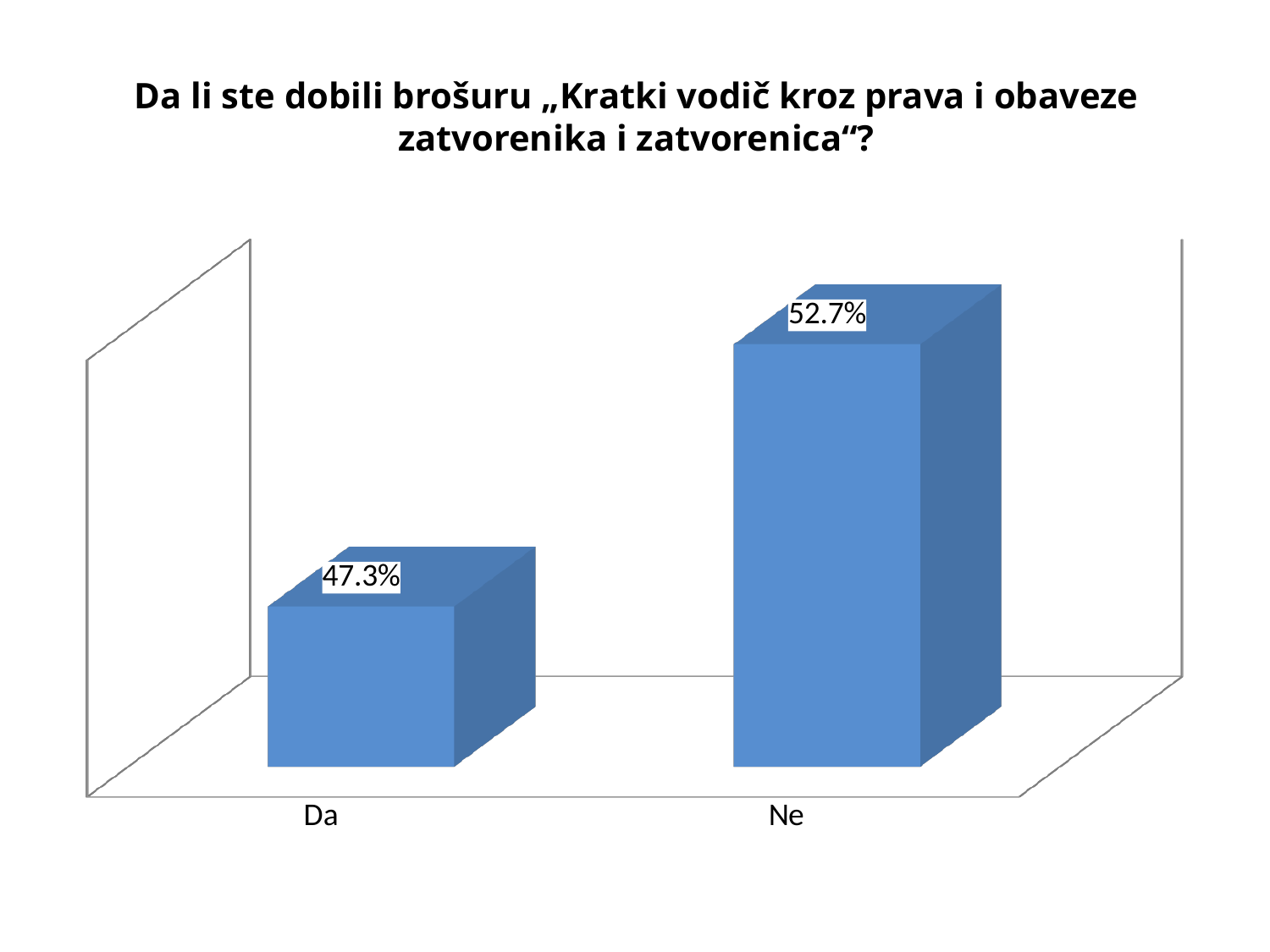
Which is larger, the value for "Da" or the value for "Ne"? Ne What is the value for "Ne"? 52.7% What colour are the bars in the chart? Blue What is the total of the two values shown in the chart? 100% What kind of chart is shown on the slide? Bar chart What is the difference between the values for "Ne" and "Da"? 5.4% Which category has the highest value? Ne What is the value for "Da"? 47.3% What is the title of the chart? Da li ste dobili brošuru „Kratki vodič kroz prava i obaveze zatvorenika i zatvorenica“? Which category has the lowest value? Da How many categories are shown in the chart? 2